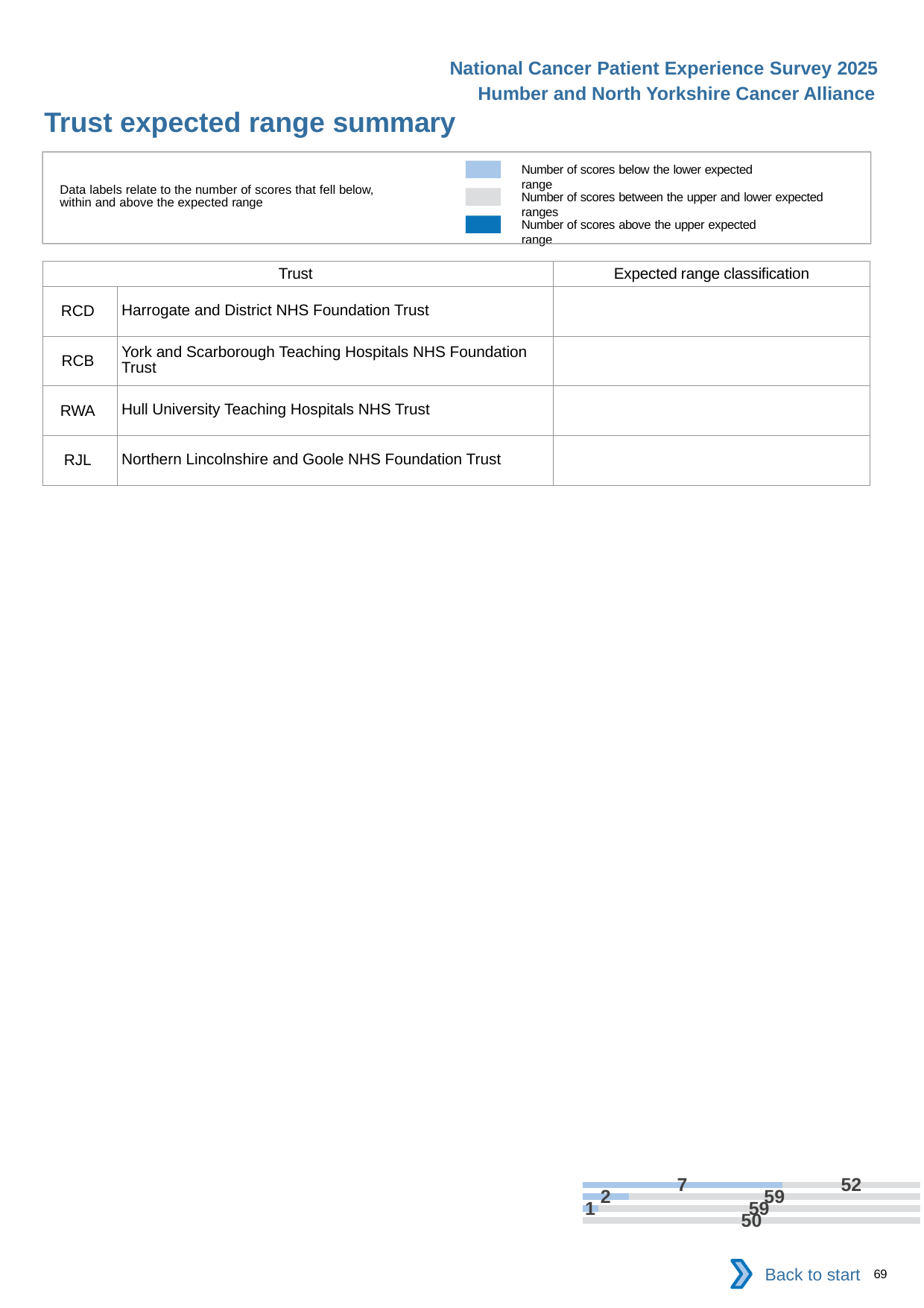
In the chart at the bottom right, what is the light blue (below lower expected range) value on the top bar? 7 In the chart at the bottom right, which bar has the largest light blue (below lower expected range) segment? the top bar In the chart at the bottom right, is the light blue value on the top bar larger or smaller than the light blue value on the second bar? larger In the chart at the bottom right, what is the grey (within expected range) value on the top bar? 52 In the chart at the bottom right, what is the light blue value on the second bar from the top? 2 How many categories does the legend at the top of the slide list for the chart? 3 In the chart at the bottom right, what is the grey value on the bottom bar? 50 What kind of chart is shown at the bottom right of the slide? stacked bar chart According to the legend, what does the dark blue colour represent? Number of scores above the upper expected range In the chart at the bottom right, what is the grey value on the second bar from the top? 59 In the chart at the bottom right, what is the total of the second bar from the top? 61